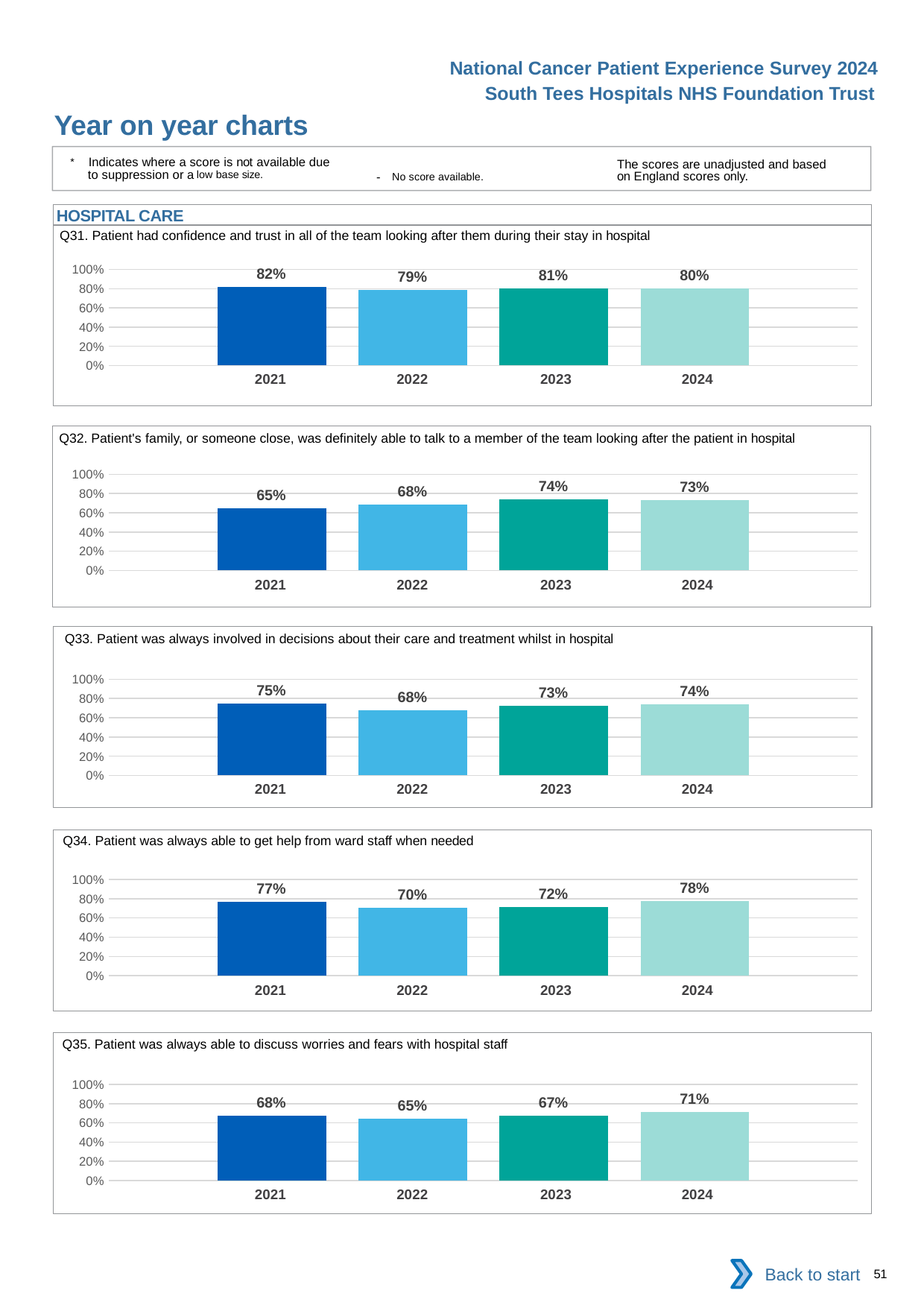
In the Q33 chart (patient was always involved in decisions about their care), what is the value for 2021? 75% In the Q33 chart (patient was always involved in decisions about their care), which is larger, the 2022 value or the 2024 value? 2024 In the Q32 chart (patient's family was definitely able to talk to a member of the team), what is the difference between the 2023 and 2021 values? 9 percentage points What type of chart is used for Q35 (patient was always able to discuss worries and fears)? Bar chart In the Q35 chart (patient was always able to discuss worries and fears), how many years are plotted? 4 In the Q32 chart (patient's family was definitely able to talk to a member of the team), which year has the lowest value? 2021 In the Q31 chart (patient had confidence and trust in all of the team), which year has the highest value? 2021 In the Q32 chart (patient's family was definitely able to talk to a member of the team), what is the value for 2024? 73% In the Q35 chart (patient was always able to discuss worries and fears), which year has the highest value? 2024 In the Q31 chart (patient had confidence and trust in all of the team), what is the value for 2022? 79% In the Q34 chart (patient was always able to get help from ward staff), what is the value for 2024? 78% In the Q34 chart (patient was always able to get help from ward staff), what is the difference between the 2021 and 2022 values? 7 percentage points